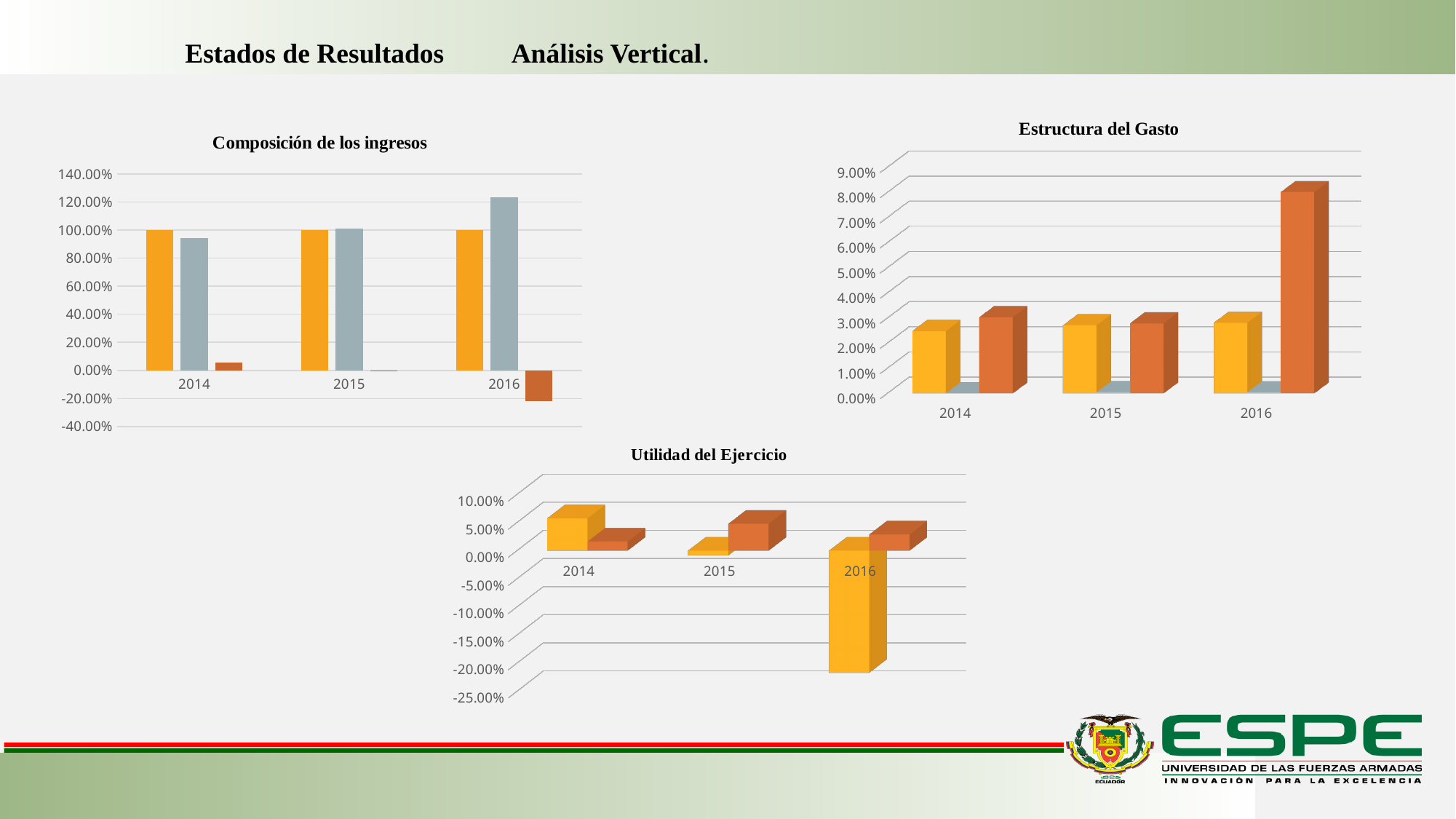
In "Composición de los ingresos", how many years are shown on the x axis? 3 In "Utilidad del Ejercicio", is the yellow bar for 2016 greater or less than -15.00%? less What kind of chart is "Composición de los ingresos"? bar chart In "Estructura del Gasto", in which year is the brown bar highest? 2016 In "Composición de los ingresos", in which year is the grey bar highest? 2016 In "Utilidad del Ejercicio", do the yellow bars rise or fall from 2014 to 2016? fall In "Estructura del Gasto", is the yellow bar for 2014 greater or less than 3.00%? less In "Utilidad del Ejercicio", in which year is the yellow bar lowest? 2016 In "Composición de los ingresos", is the grey bar for 2016 greater or less than 120.00%? greater In "Composición de los ingresos", what is the value of the orange bar for 2015? 100.00%